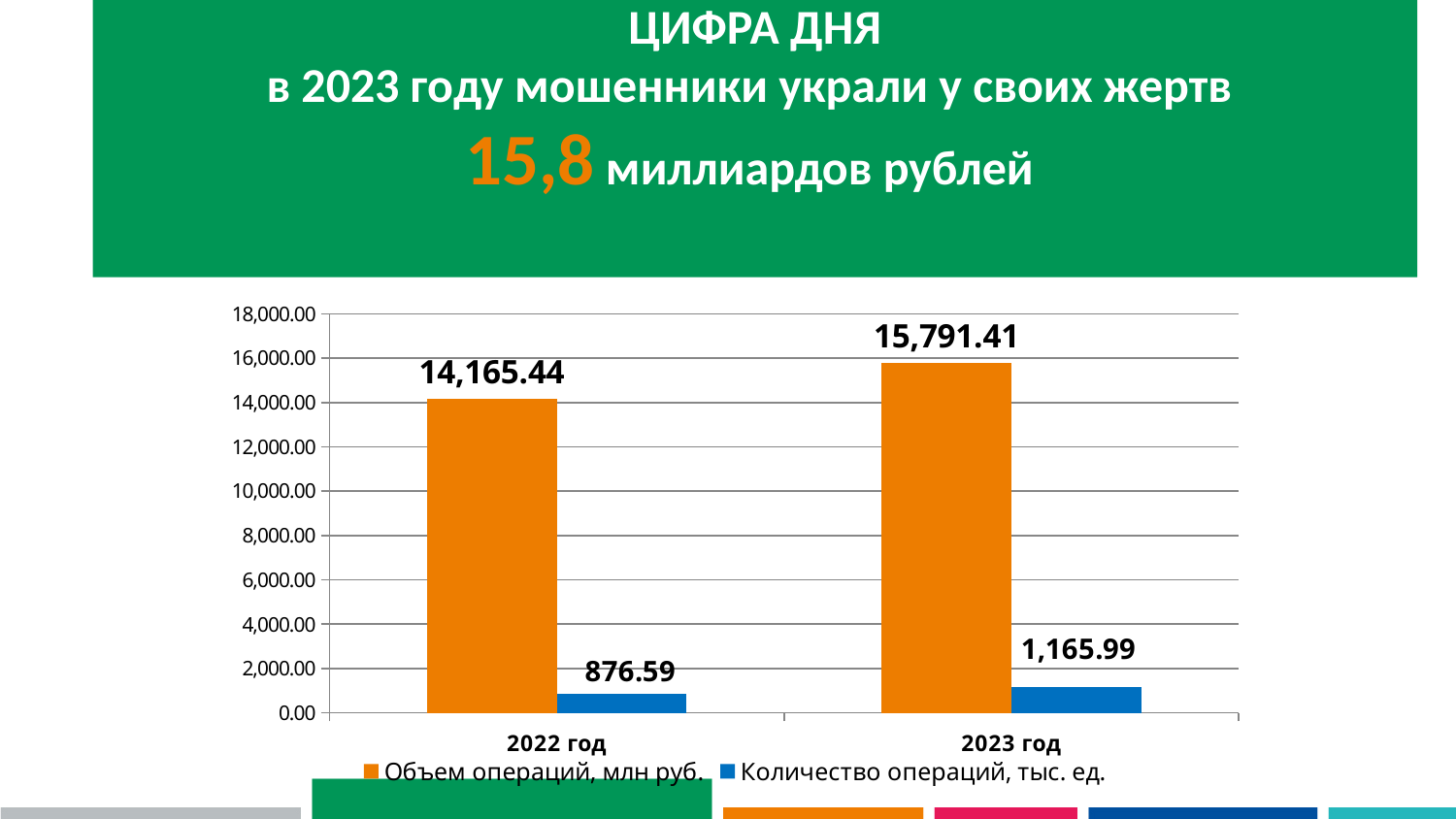
Is the value of "Объем операций, млн руб." for 2023 год greater or less than 16,000.00? less What is the value of "Количество операций, тыс. ед." for 2022 год? 876.59 Which year has the lower value for "Количество операций, тыс. ед."? 2022 год What is the difference between the "Количество операций, тыс. ед." values for 2023 год and 2022 год? 289.40 How many categories are shown on the x axis of the chart? 2 What is the value of "Объем операций, млн руб." for 2023 год? 15,791.41 What is the difference between the "Объем операций, млн руб." values for 2023 год and 2022 год? 1,625.97 How many series does the chart legend list? 2 What type of chart is shown on the slide? bar chart What is the value of "Количество операций, тыс. ед." for 2023 год? 1,165.99 Which year has the higher value for "Объем операций, млн руб."? 2023 год What is the value of "Объем операций, млн руб." for 2022 год? 14,165.44